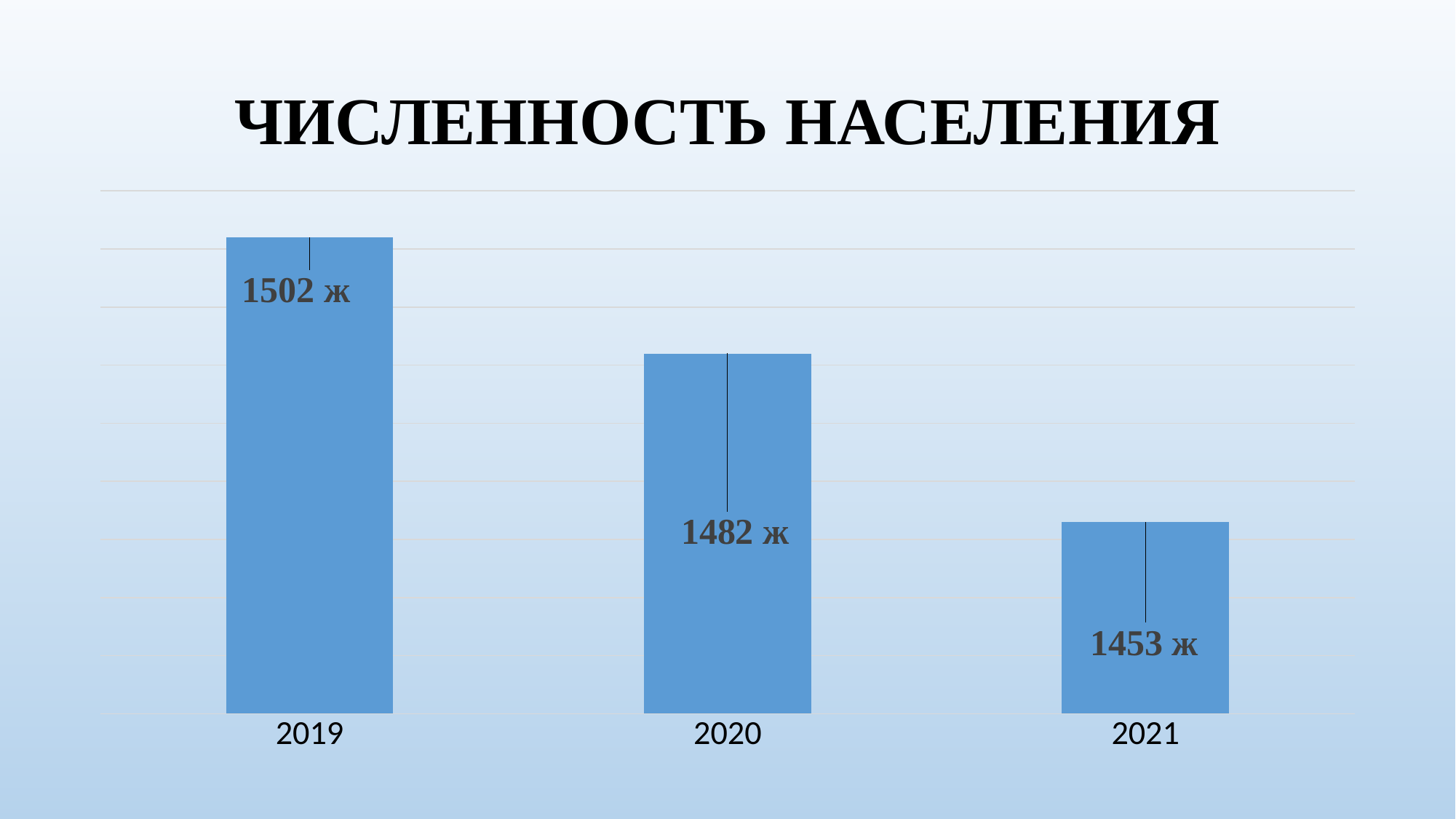
What is the difference between the 2019 and 2021 values? 49 Do the values rise or fall from 2019 to 2021? fall What is the difference between the 2020 and 2021 values? 29 Which year has the highest population value? 2019 What kind of chart is shown on the slide? bar chart What is the population value shown for 2019? 1502 ж How many years are shown on the x axis? 3 Which year has the lowest population value? 2021 What is the population value shown for 2020? 1482 ж What is the difference between the 2019 and 2020 values? 20 What is the population value shown for 2021? 1453 ж Which is larger, the value for 2020 or the value for 2021? 2020